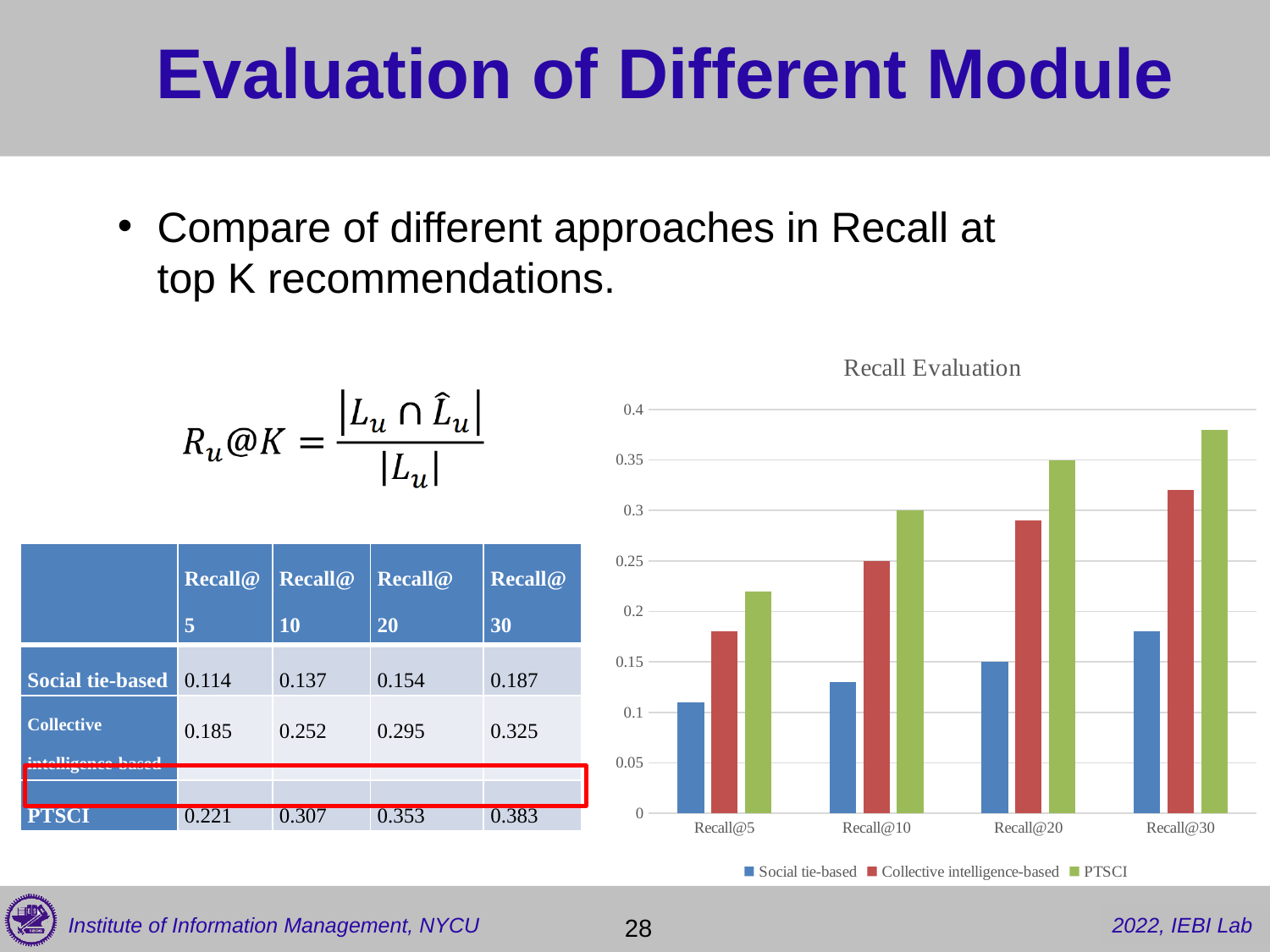
Do the values for PTSCI rise or fall from Recall@5 to Recall@30? rise Is the value for Social tie-based at Recall@5 greater or less than 0.15? less Is the value for Collective intelligence-based at Recall@30 greater or less than 0.3? greater At Recall@20, which is larger: PTSCI or Social tie-based? PTSCI How many series does the chart legend list? 3 What is the title of the chart? Recall Evaluation How many categories are shown on the x axis of the chart? 4 Which series has the highest bar in the chart? PTSCI Is the value for PTSCI at Recall@30 greater or less than 0.35? greater Which series has the lowest bar in the chart? Social tie-based What type of chart is shown on the slide? bar chart